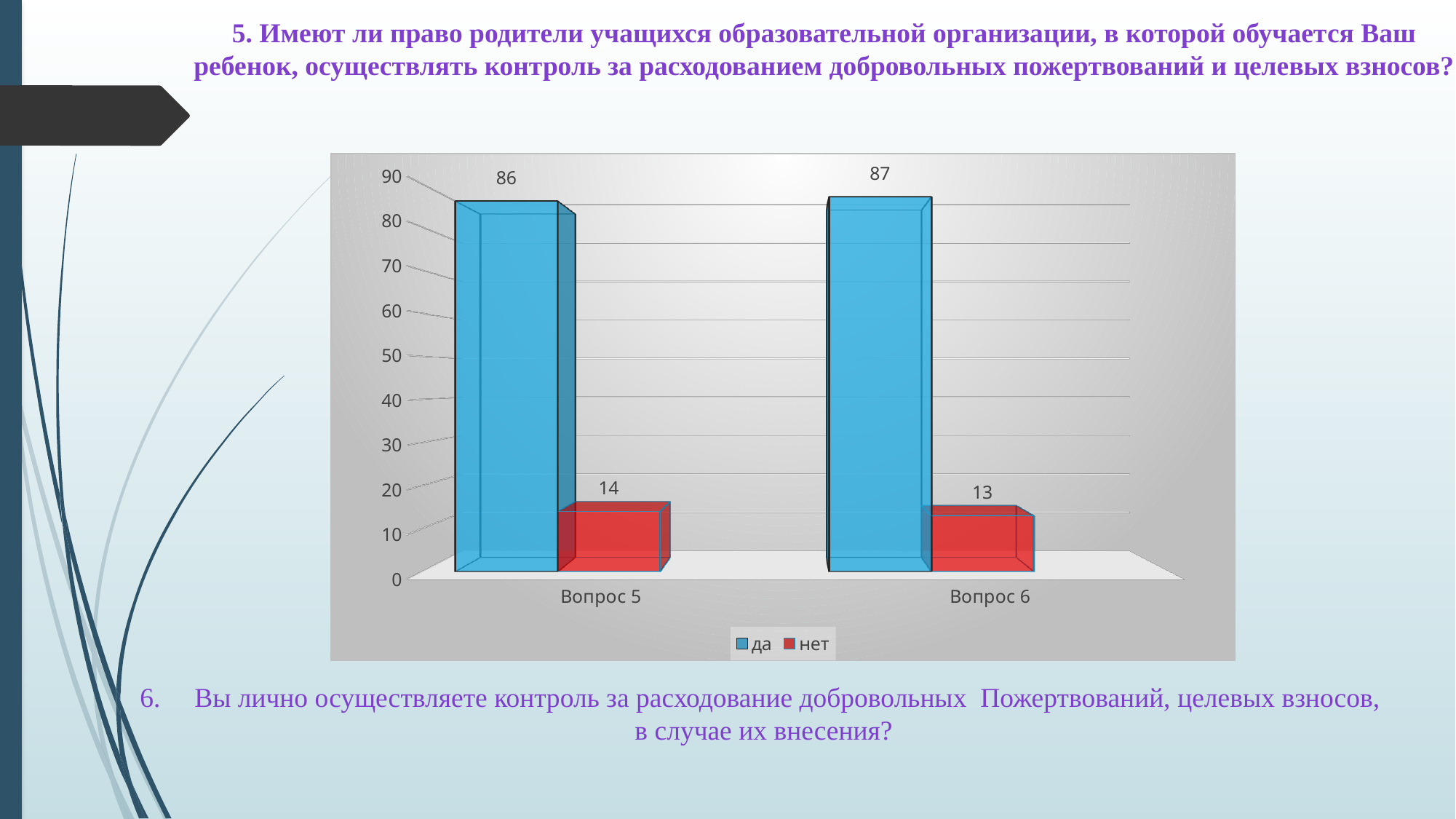
How many series does the legend list? 2 What colour are the bars for the "нет" series? red What is the value for "да" for Вопрос 6? 87 What is the value for "нет" for Вопрос 6? 13 What kind of chart is shown on the slide? bar chart What is the difference between the "да" and "нет" values for Вопрос 5? 72 Which is larger for Вопрос 6: "да" or "нет"? да What is the value for "да" for Вопрос 5? 86 Which category has the lowest value for "нет"? Вопрос 6 How many categories are shown on the x axis? 2 What is the value for "нет" for Вопрос 5? 14 Which category has the highest value for "да"? Вопрос 6